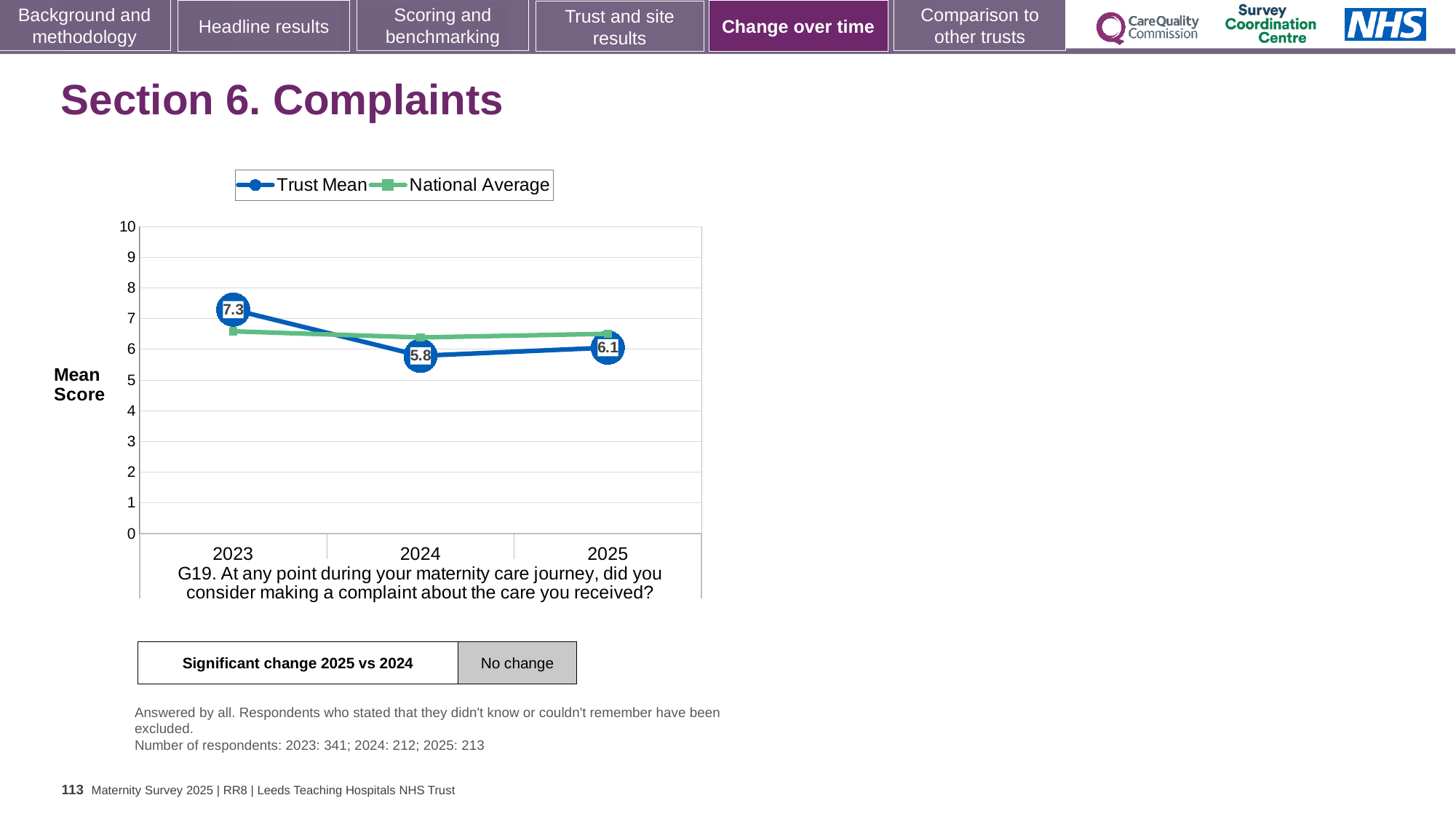
What is the Trust Mean score for 2024? 5.8 In which year is the Trust Mean score highest? 2023 How many series does the legend list? 2 Is the National Average value for 2023 greater or less than 6? greater What is the Trust Mean score for 2025? 6.1 Which is larger in 2023, the Trust Mean or the National Average? Trust Mean What is the Trust Mean score for 2023? 7.3 What is the difference between the Trust Mean score in 2023 and in 2024? 1.5 Does the Trust Mean rise or fall from 2023 to 2024? fall Which is larger in 2024, the Trust Mean or the National Average? National Average What kind of chart is shown on the slide? line chart In which year is the Trust Mean score lowest? 2024